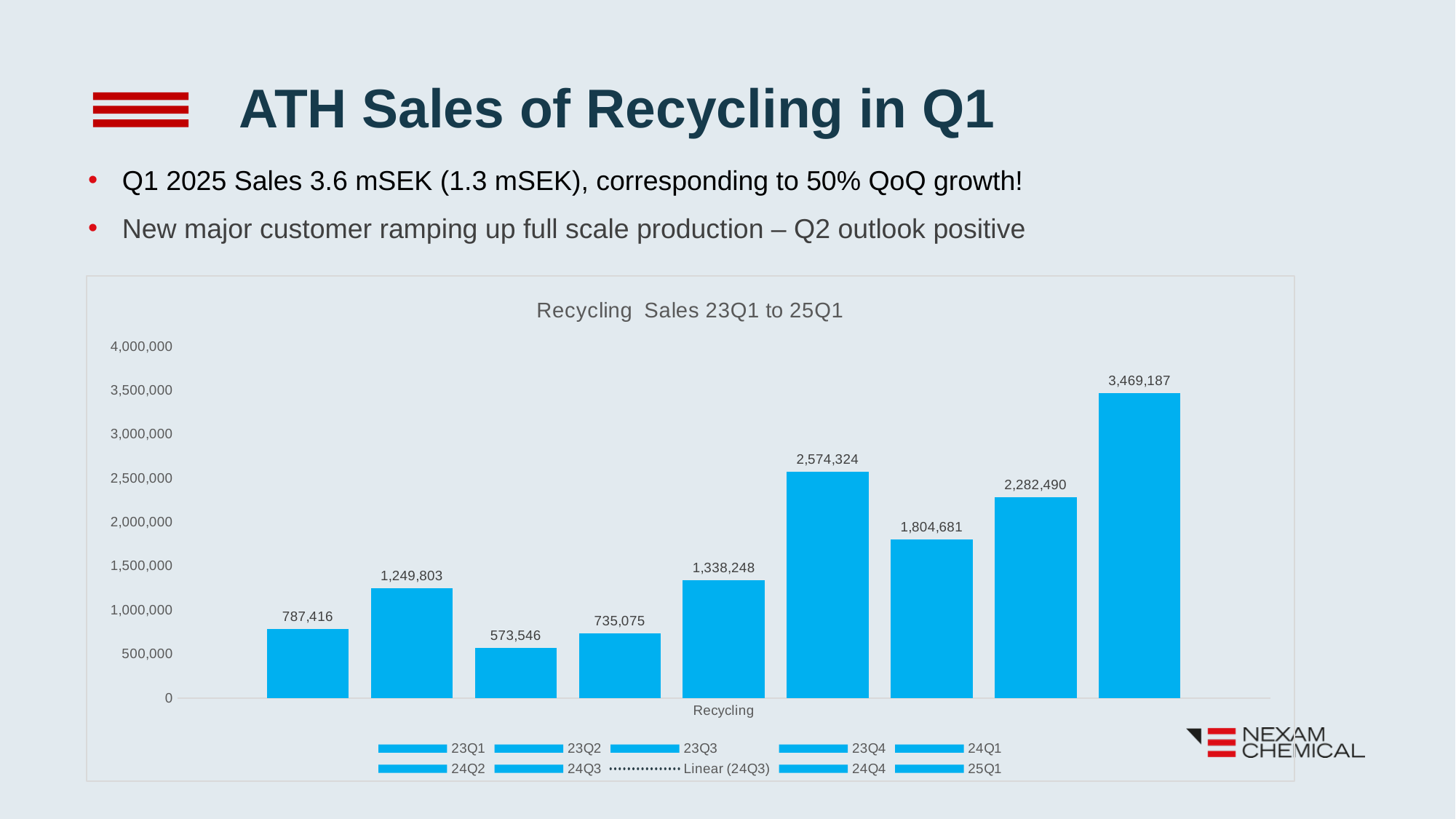
Which quarter has the lowest recycling sales? 23Q3 What is the title of the chart? Recycling Sales 23Q1 to 25Q1 How many bars are plotted in the chart? 9 What is the recycling sales value for 24Q2? 2,574,324 Which quarter has the highest recycling sales? 25Q1 What is the recycling sales value for 23Q3? 573,546 What is the difference between the 25Q1 and 24Q4 recycling sales values? 1,186,697 How many entries does the chart legend list? 10 What is the recycling sales value for 25Q1? 3,469,187 What is the difference between the 23Q2 and 23Q1 recycling sales values? 462,387 What type of chart is shown on the slide? Bar chart Which is larger, the recycling sales for 24Q2 or for 24Q4? 24Q2